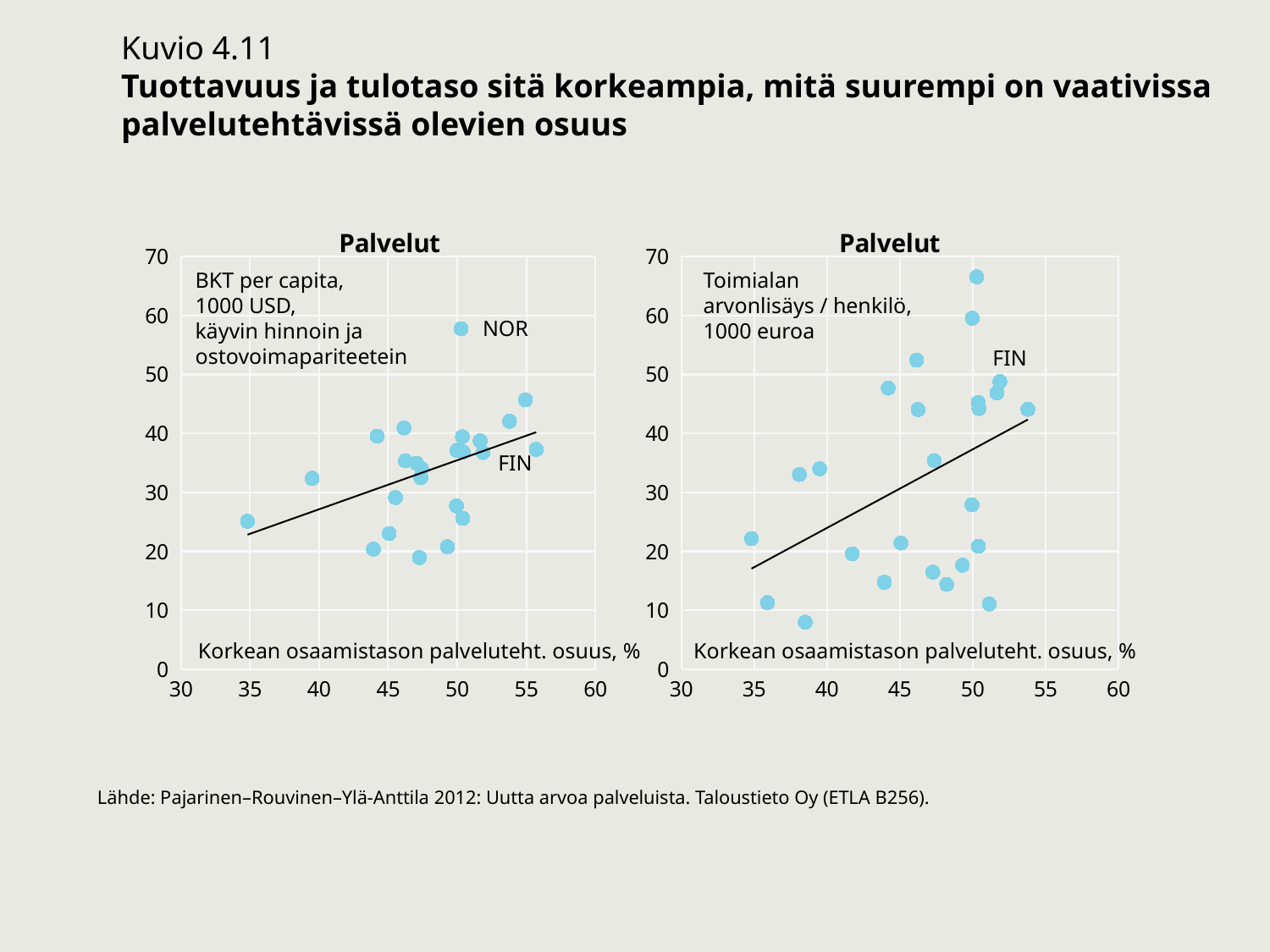
In the right chart (Toimialan arvonlisäys / henkilö), is the highest plotted point greater or less than 60? greater In the right chart (Toimialan arvonlisäys / henkilö), is the value for FIN greater or less than 40? greater In the right chart (Toimialan arvonlisäys / henkilö), does the fitted line rise or fall along the x axis? rise In the left chart (BKT per capita), which labelled point is higher, NOR or FIN? NOR In the left chart (BKT per capita), is the value for FIN greater or less than 30? greater In the left chart (BKT per capita), does the fitted line rise or fall as the share of high-skill service jobs increases along the x axis? rise What is the x-axis label of the right chart? Korkean osaamistason palveluteht. osuus, % What is the title shown above each of the two charts? Palvelut What kind of chart is the left chart titled "Palvelut"? scatter chart